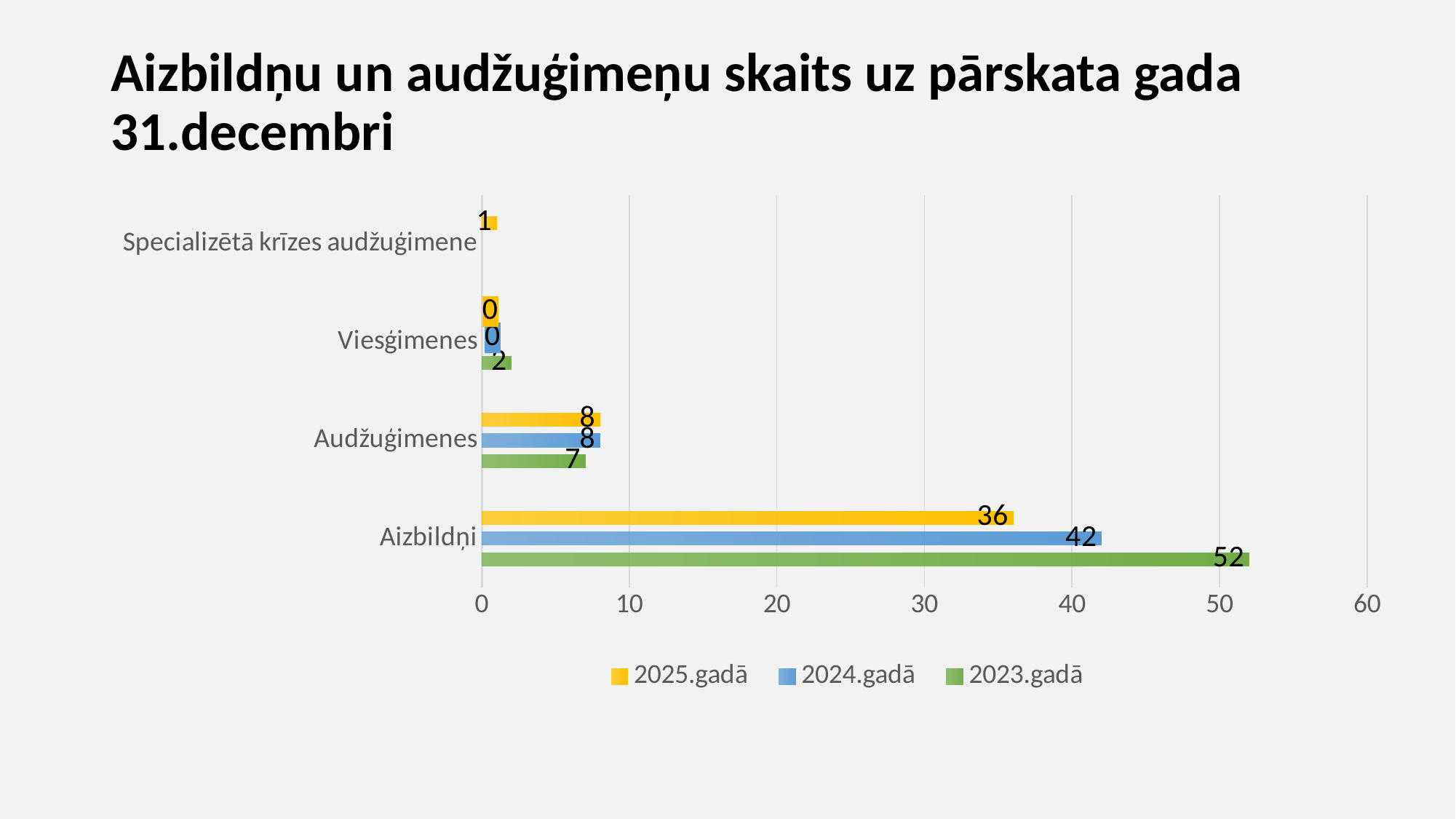
What is the value for Audžuģimenes in the 2023.gadā series? 7 Is the 2023.gadā value for Aizbildņi greater or less than 50? greater What is the value for Aizbildņi in the 2025.gadā series? 36 Which is larger for Aizbildņi: the 2024.gadā value or the 2025.gadā value? 2024.gadā How many categories are shown on the chart? 4 What is the value for Specializētā krīzes audžuģimene in the 2025.gadā series? 1 Which colour represents the 2024.gadā series? blue Which category has the highest value in the 2024.gadā series? Aizbildņi What is the value for Aizbildņi in the 2023.gadā series? 52 What kind of chart is shown on the slide? bar chart What is the difference between the 2023.gadā and 2025.gadā values for Aizbildņi? 16 How many series does the legend list? 3